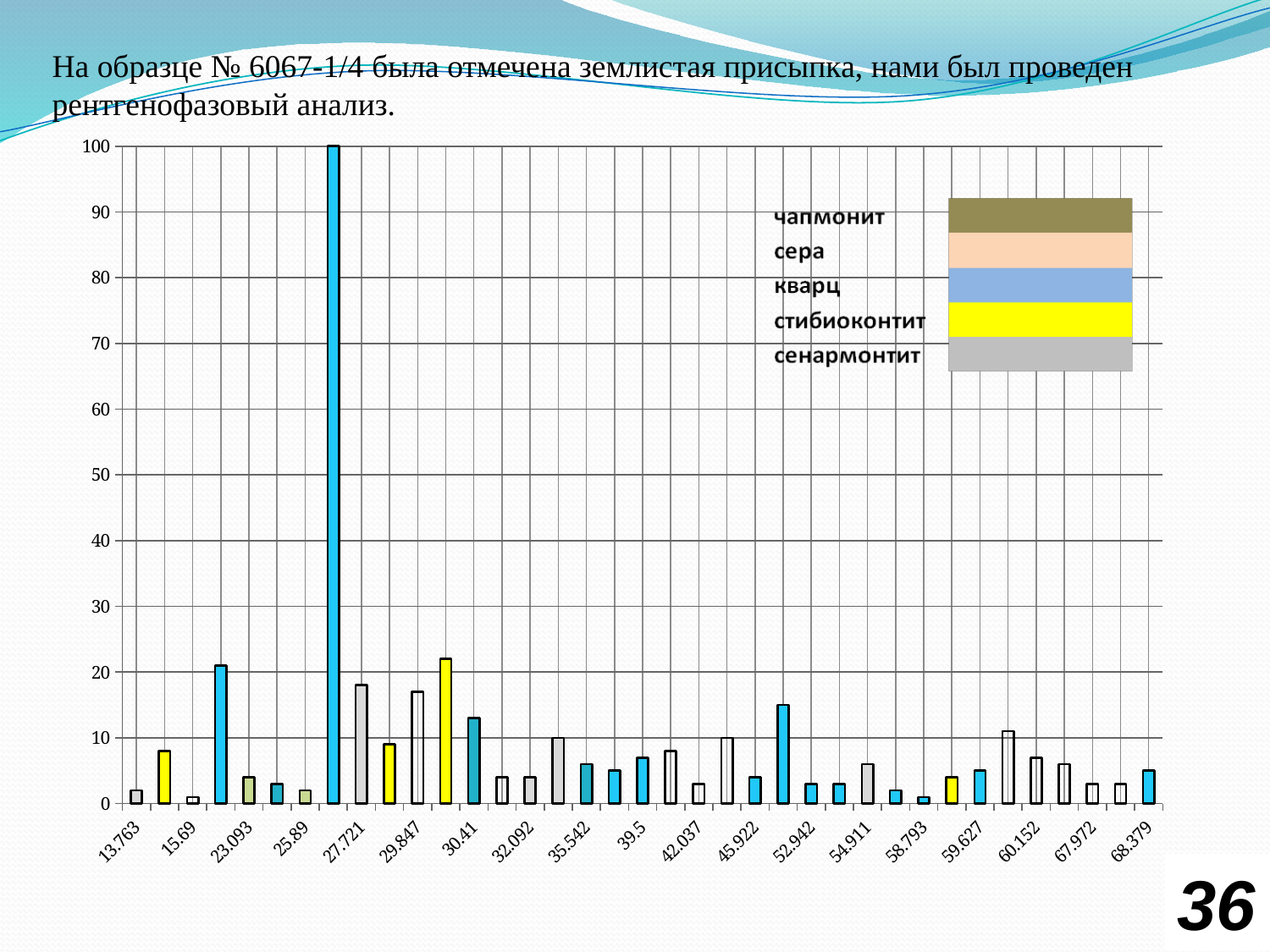
Is the value for 30.41 greater or less than 20? less Is the value for 29.847 greater or less than 10? greater Is the value for 27.721 greater or less than 20? less What is the first entry listed in the chart legend? чапмонит Which has the larger value, 30.41 or 58.793? 30.41 How many entries does the chart legend list? 5 What kind of chart is shown on the slide? bar chart Which has the larger value, 27.721 or 13.763? 27.721 What value does the tallest bar in the chart reach? 100